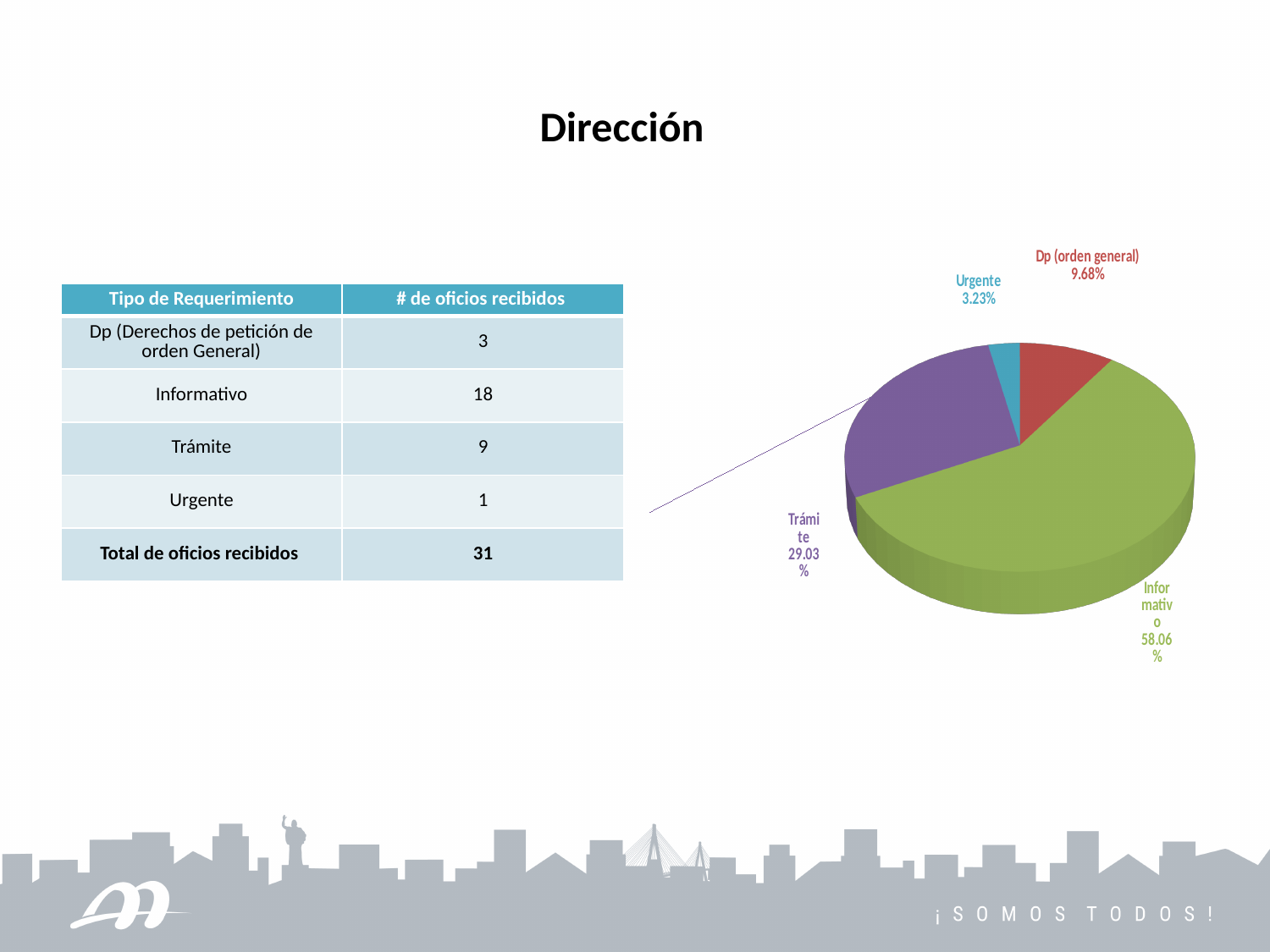
What colour is the Informativo slice in the pie chart? green What kind of chart is shown on the slide? pie chart In the pie chart, which is larger: Trámite or Dp (orden general)? Trámite What share of the pie chart does Informativo represent? 58.06% What share of the pie chart does Urgente represent? 3.23% What is the difference in percentage points between the Informativo and Trámite slices of the pie chart? 29.03 Which slice of the pie chart is the smallest? Urgente What colour is the Trámite slice in the pie chart? purple How many slices does the pie chart have? 4 Which slice of the pie chart is the largest? Informativo What share of the pie chart does Trámite represent? 29.03%